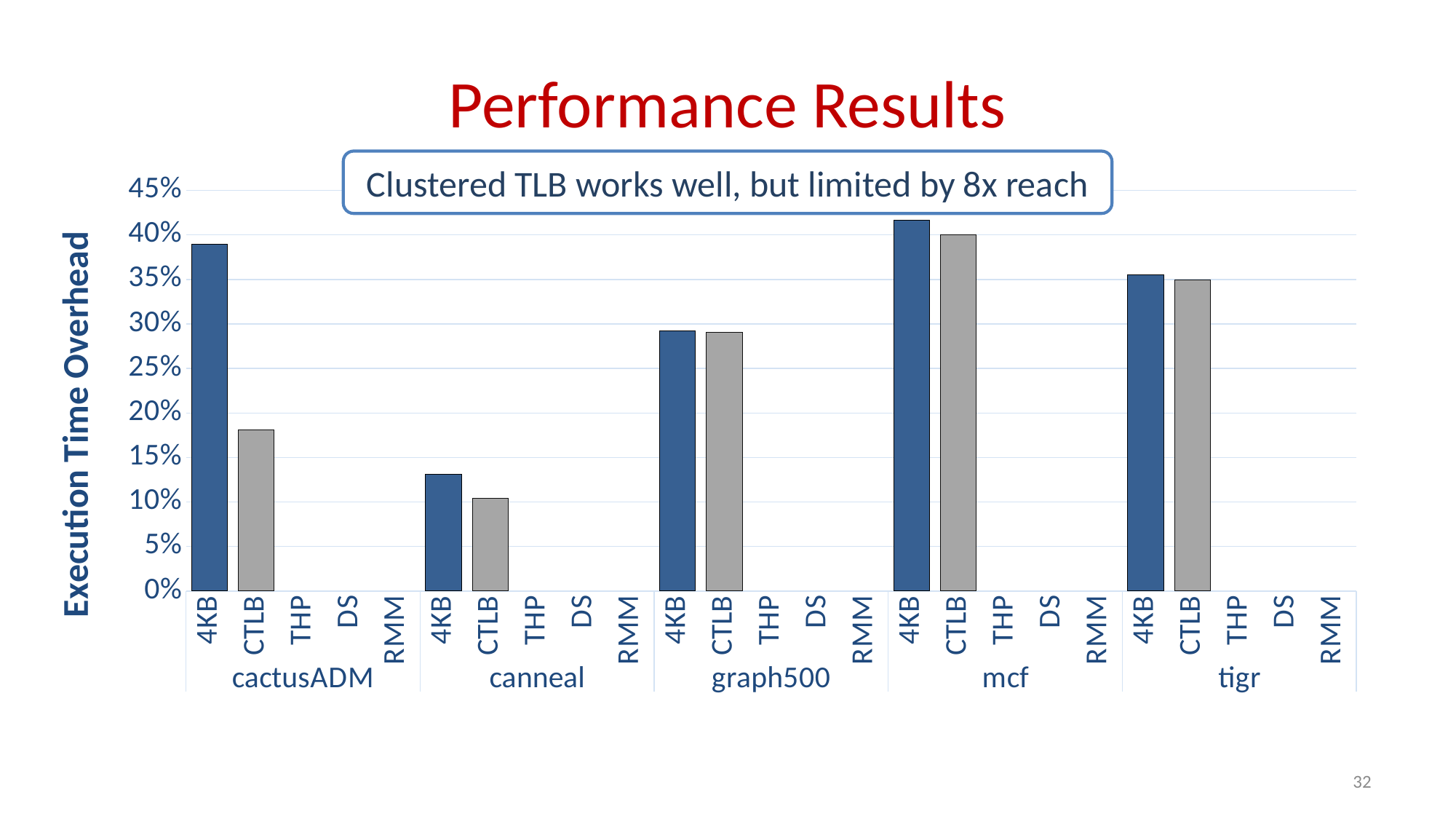
Which benchmark has the highest 4KB execution time overhead? mcf How many benchmark groups are shown along the x axis? 5 Is the 4KB execution time overhead for mcf greater or less than 40%? greater For cactusADM, which is larger: the 4KB overhead or the CTLB overhead? 4KB What does the callout box on the chart say? Clustered TLB works well, but limited by 8x reach Is the CTLB execution time overhead for cactusADM greater or less than 20%? less Which benchmark has the lowest CTLB execution time overhead? canneal What is the y-axis title of the chart? Execution Time Overhead What kind of chart is shown on the slide? bar chart Is the CTLB execution time overhead for canneal greater or less than 15%? less Which benchmark has the lowest 4KB execution time overhead? canneal